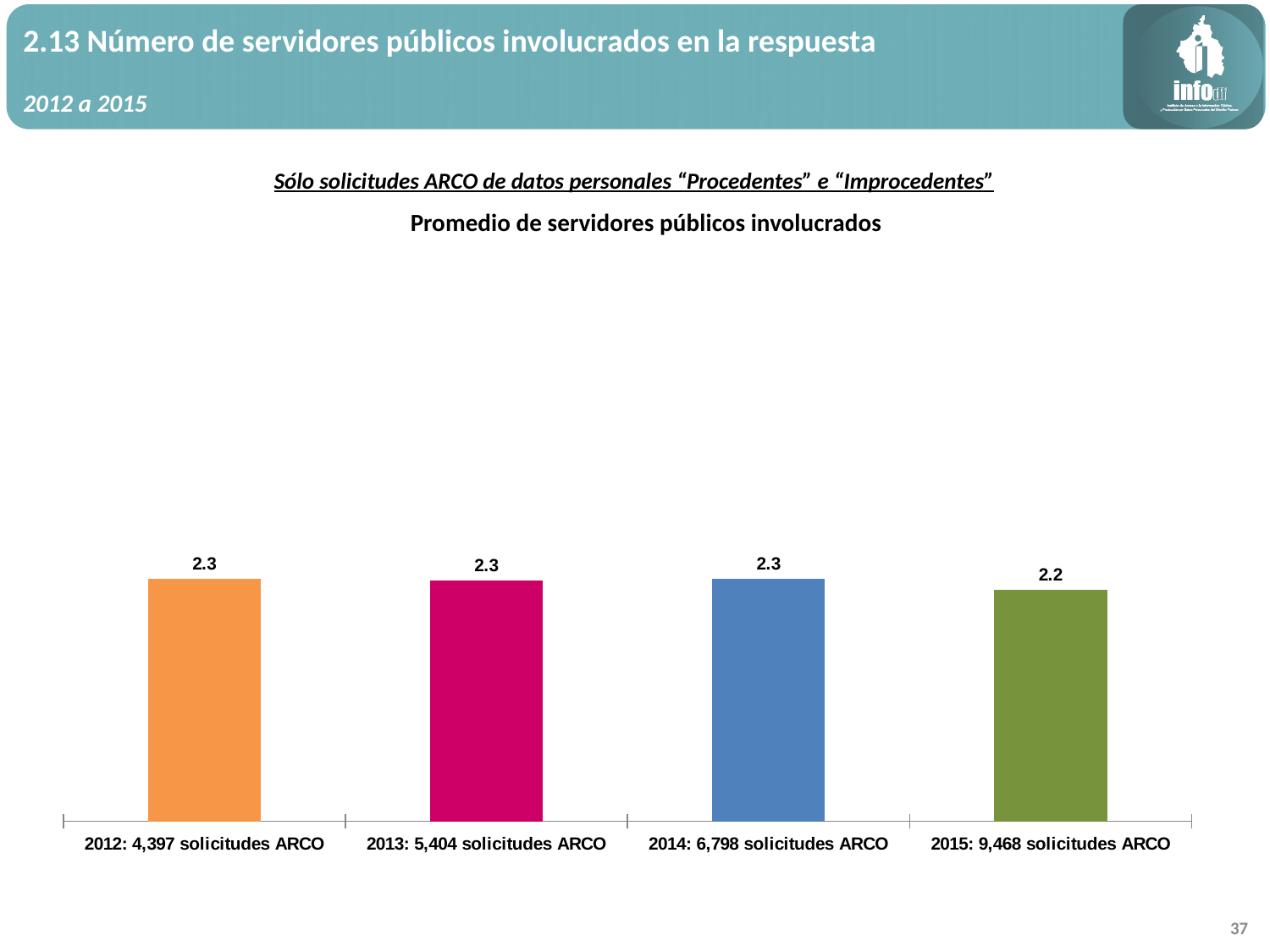
Do the values rise, fall, or stay roughly flat from 2012 to 2015? roughly flat, with a slight fall in 2015 What is the average number of public servants involved for 2012? 2.3 What kind of chart is shown on the slide? bar chart What colour is the bar for 2013? magenta/pink Which year has the lowest average number of public servants involved? 2015 What is the difference between the values for 2012 and 2015? 0.1 What is the value shown for 2015? 2.2 What is the value shown for 2014? 2.3 Is the value for 2013 larger than, smaller than, or equal to the value for 2014? equal How many years (categories) are shown in the chart? 4 How many ARCO requests are noted in the axis label for 2015? 9,468